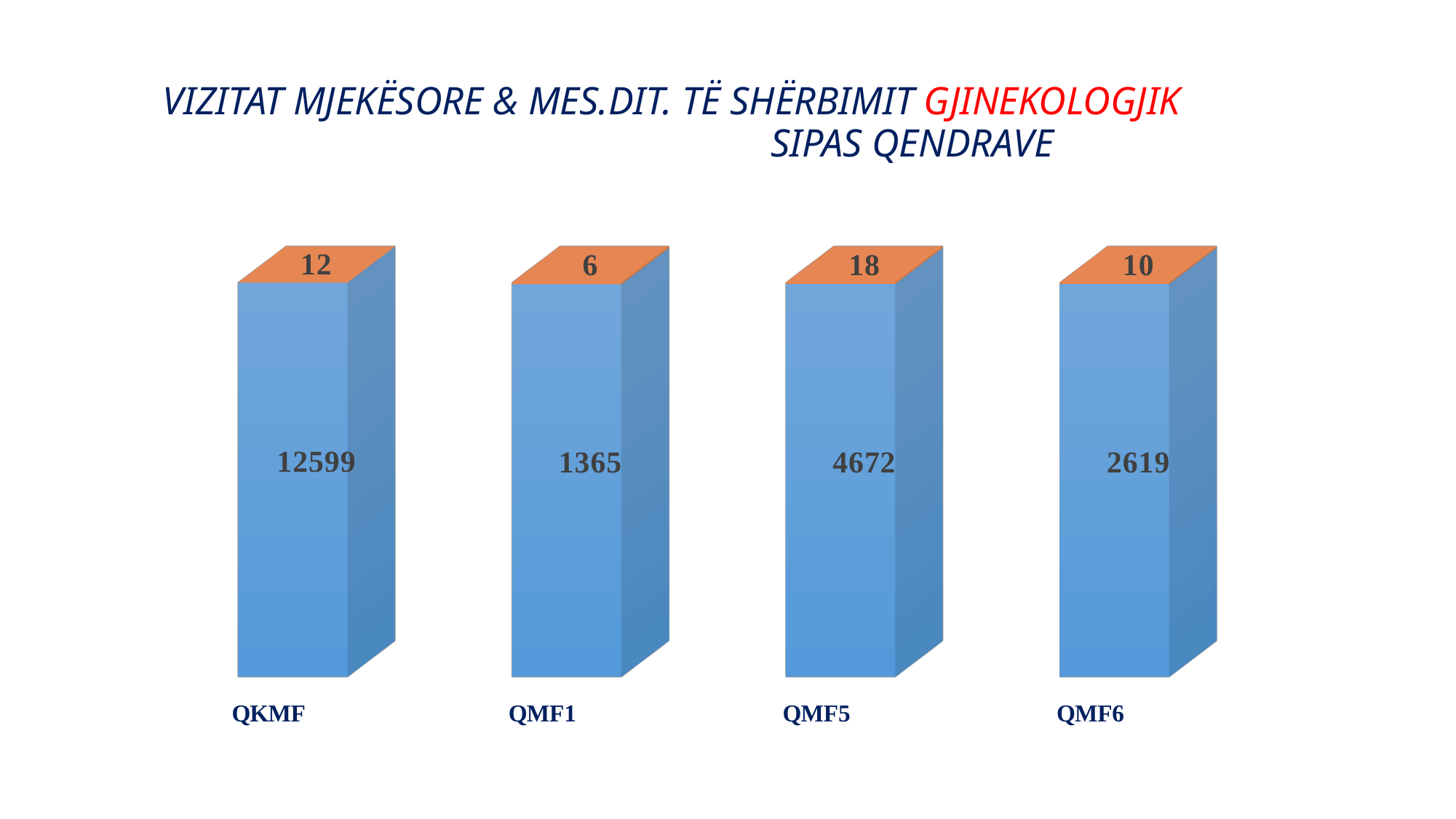
What is the daily average (the value on the orange top) for QMF6? 10 Which centre has the highest daily average value shown on the orange top? QMF5 Which word in the slide title is written in red? GJINEKOLOGJIK What kind of chart is shown on the slide? Bar chart What is the number of medical visits shown on the blue bar for QMF5? 4672 How many centres are shown on the chart? 4 What is the difference in medical visits between QMF5 and QMF6? 2053 Which has more medical visits, QMF1 or QMF6? QMF6 Which centre has the lowest number of medical visits? QMF1 What is the number of medical visits (the large value on the blue bar) for QKMF? 12599 What is the daily average (the value on the orange top) for QMF1? 6 Which centre has the highest number of medical visits? QKMF